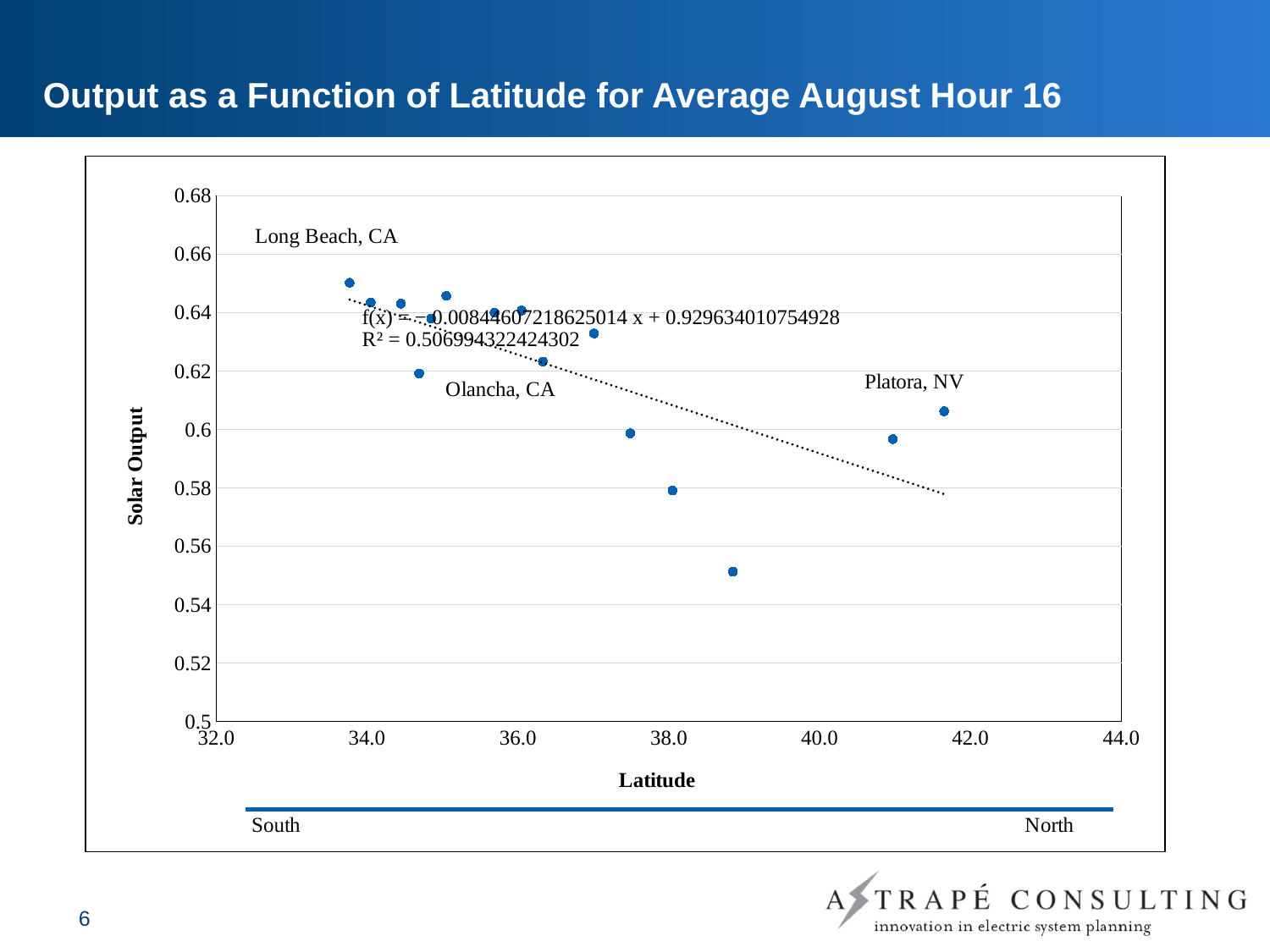
How many data points are plotted on the chart? 15 What is the maximum value shown on the Latitude axis? 44.0 Which has the higher solar output, the point labeled Long Beach, CA or the point labeled Olancha, CA? Long Beach, CA Is the solar output of the point labeled Long Beach, CA greater or less than 0.64? greater Is the solar output of the point labeled Platora, NV greater or less than 0.58? greater What is the title of the chart on the slide? Output as a Function of Latitude for Average August Hour 16 What kind of chart is shown on the slide? Scatter chart What is the label of the vertical axis? Solar Output What R² value is printed for the trendline? 0.506994322424302 What is the intercept term in the printed trendline equation f(x)? 0.929634010754928 Is the solar output of the lowest point (near latitude 39) greater or less than 0.58? less As latitude increases along the x axis, do the solar output values generally rise or fall? Fall